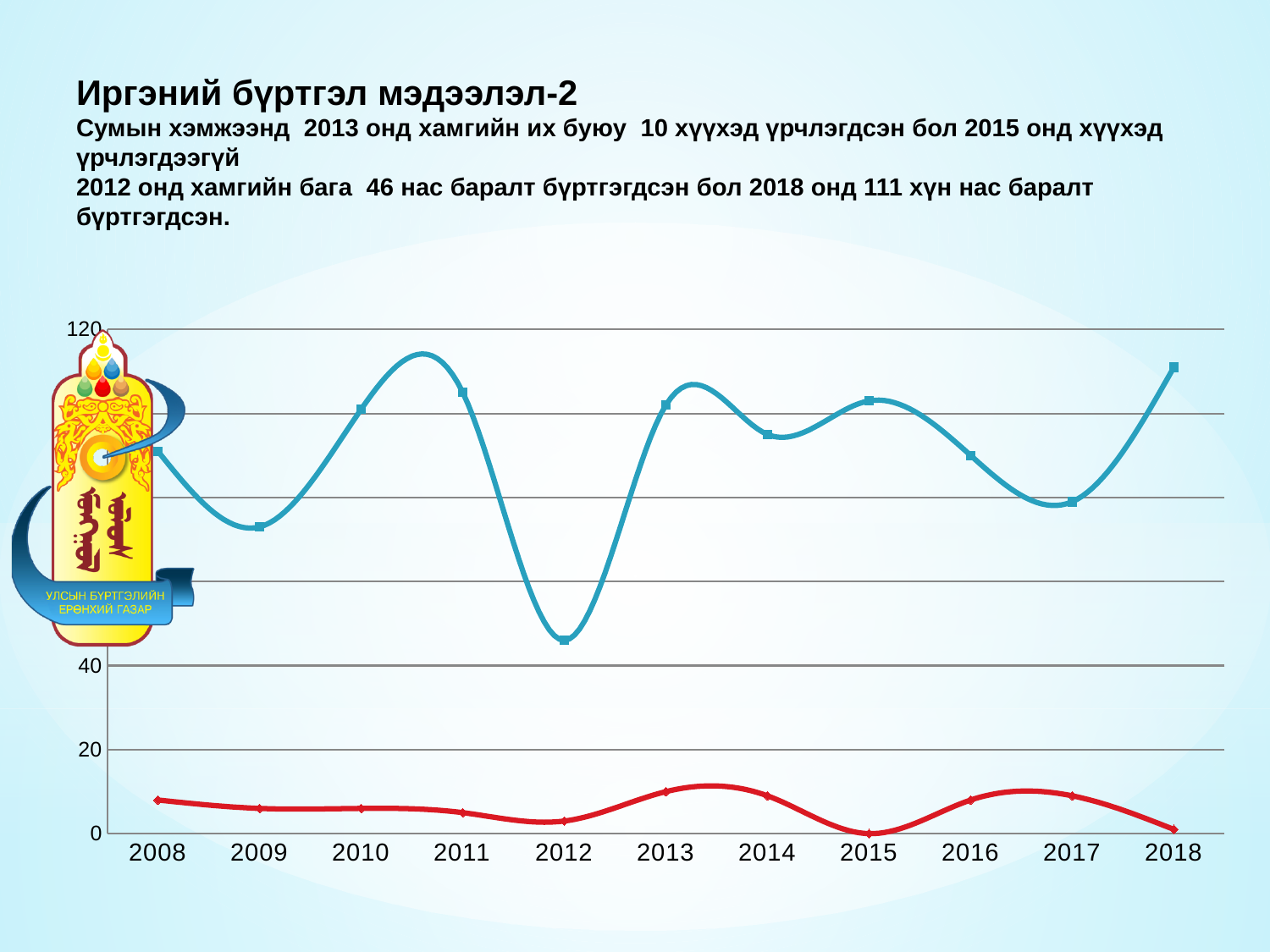
How many years are shown along the x axis of the chart? 11 In which year does the red line reach its lowest point? 2015 Which year has the larger value on the blue line, 2009 or 2012? 2009 In which year does the blue line reach its lowest point? 2012 Is the value of the blue line in 2018 greater or less than 100? greater Does the blue line rise or fall from 2012 to 2013? rise Is the value of the blue line in 2009 greater or less than 80? less How many lines are plotted on the chart? 2 What is the value of the red line in 2015? 0 What kind of chart is shown on the slide? line chart Is the value of the blue line in 2012 greater or less than 40? greater In which year does the blue line reach its highest point? 2018